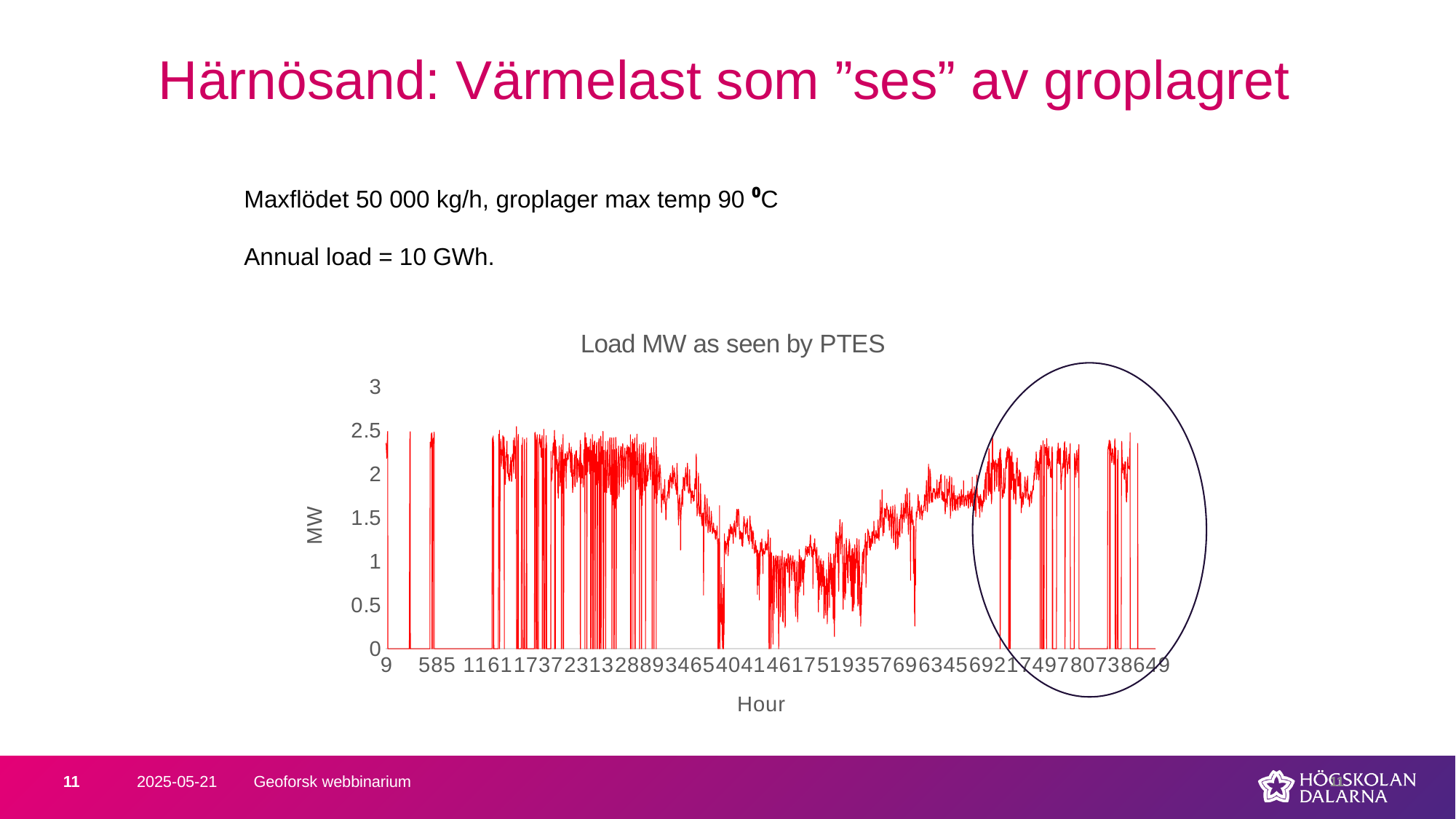
Is the highest load value on the chart greater or less than 3 MW? less What is the title of the chart? Load MW as seen by PTES What is the label of the vertical axis of the chart? MW What is the lowest value the load line reaches on the chart? 0 Is the highest load value on the chart greater or less than 2 MW? greater Is the load in the middle of the chart (around hour 4614) greater or less than 1.5 MW? less Does the load generally rise or fall from the middle of the x axis toward the right end of the chart? rise What is the highest tick value shown on the vertical axis of the chart? 3 Does the load generally fall or rise from the start of the chart toward the middle of the x axis? fall What colour is the load line on the chart? red What kind of chart is shown on the slide? line chart